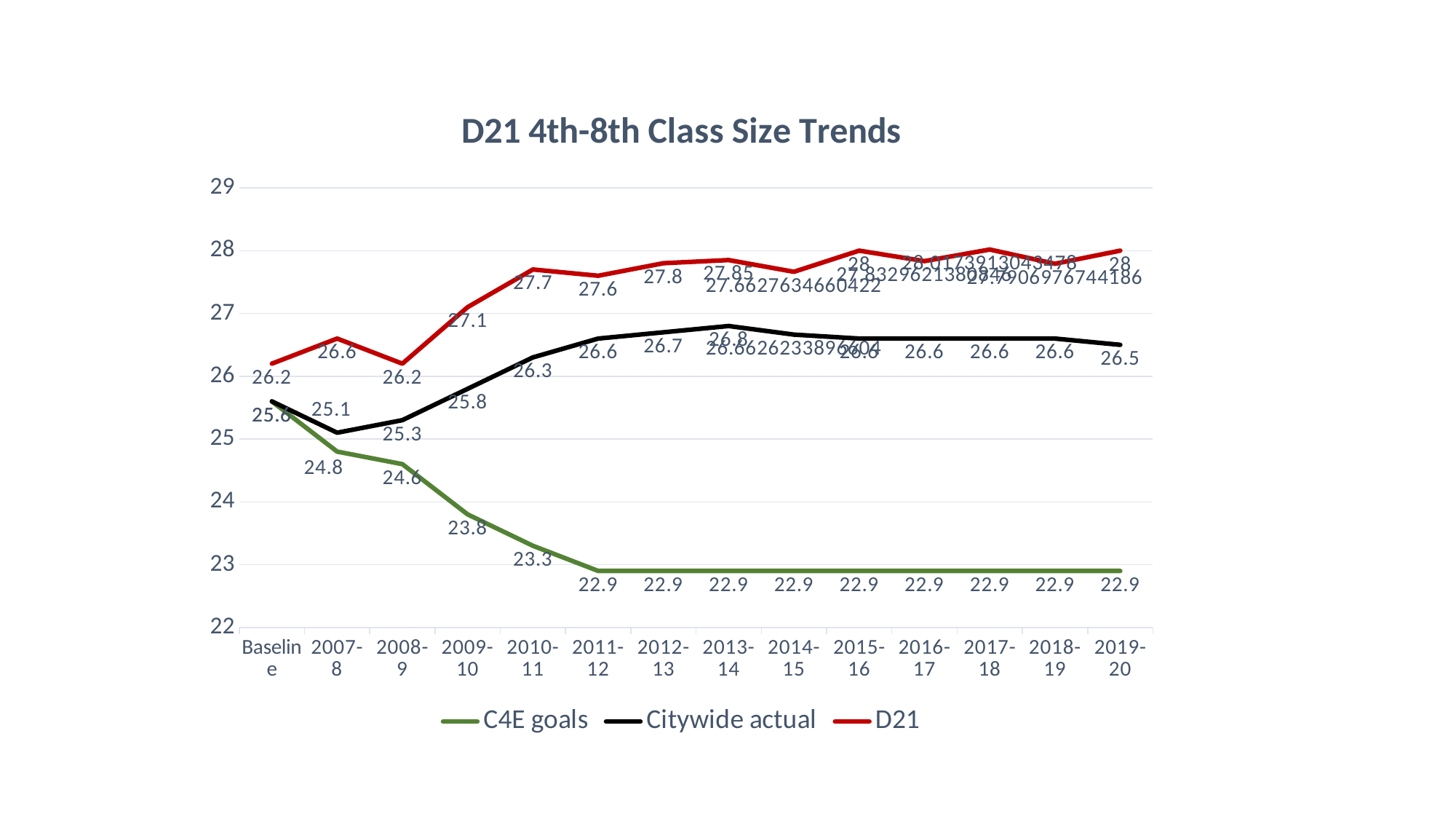
Do the C4E goals values rise or fall from Baseline to 2011-12? fall What is the C4E goals value for 2009-10? 23.8 What kind of chart is shown on the slide? line chart In which category is the C4E goals series highest? Baseline How many series does the legend list? 3 In 2007-8, which is larger: D21 or Citywide actual? D21 What is the D21 value for 2010-11? 27.7 In which category is the Citywide actual series lowest? 2007-8 What is the difference between the D21 and Citywide actual values in 2010-11? 1.4 What is the D21 value at Baseline? 26.2 What is the Citywide actual value for 2019-20? 26.5 How many categories are shown on the x axis? 14